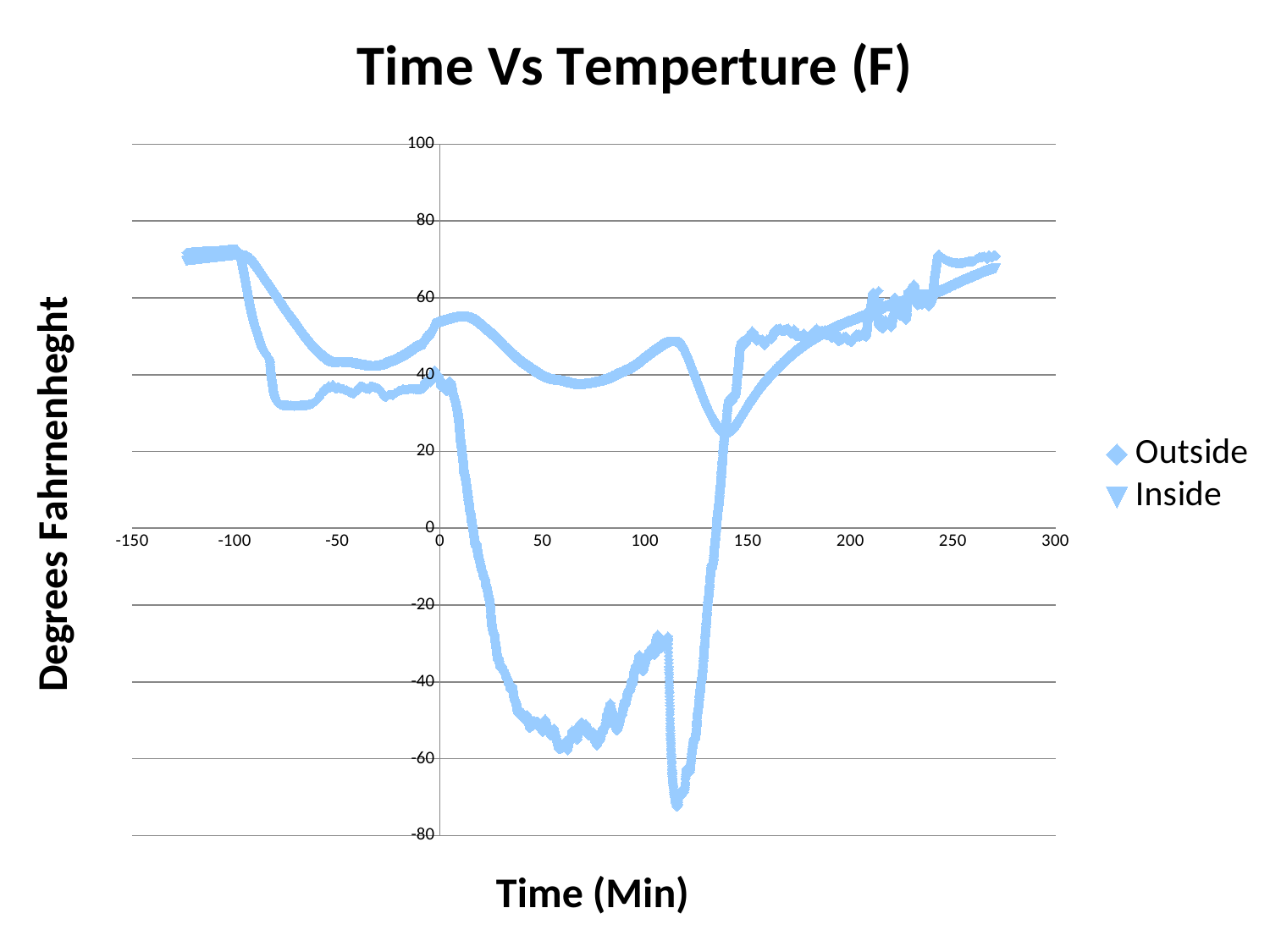
Is the lowest point plotted on the chart greater or less than -60? less What kind of chart is shown on the slide? Scatter chart What is the title of the chart? Time Vs Temperture (F) What are the two series named in the legend? Outside and Inside What is the highest value shown on the y axis? 100 Is the highest point plotted on the chart greater or less than 60? greater Between 150 and 270 minutes, do the plotted values generally rise or fall? rise Between 0 and 50 minutes, does the series that drops below zero rise or fall? fall How many series does the legend list? 2